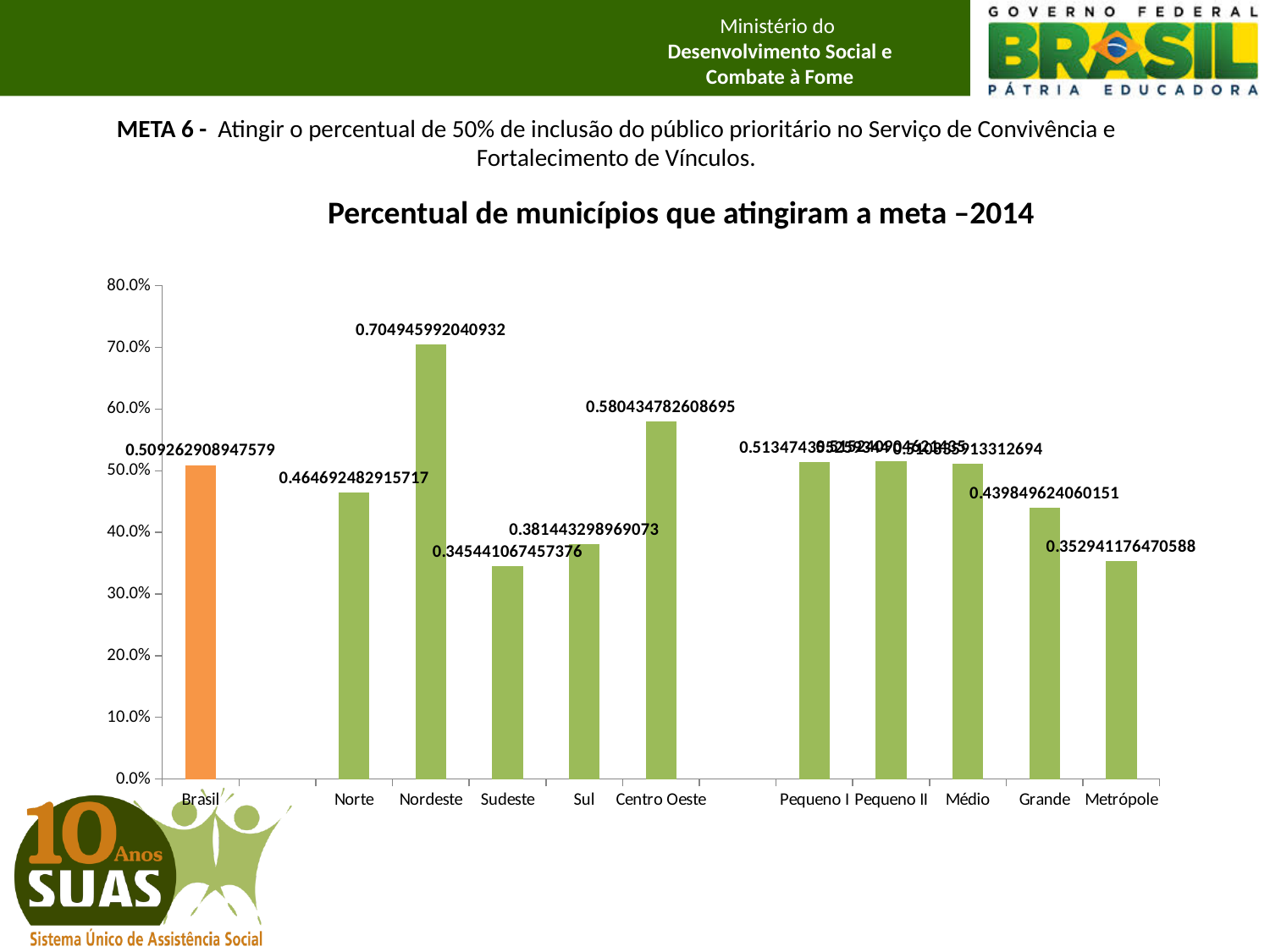
Which category has the highest value? Nordeste Is the value for Médio greater or less than 40.0%? greater How many categories are plotted on the x axis of the chart? 11 What is the title of the chart? Percentual de municípios que atingiram a meta –2014 What is the value shown for Metrópole? 0.352941176470588 What is the value shown for Centro Oeste? 0.580434782608695 What is the value shown for Nordeste? 0.704945992040932 What is the difference between the values for Nordeste and Sudeste? 0.359504924583556 Which bar is shown in a different colour (orange) from the others? Brasil Which has a larger value, Norte or Grande? Norte What is the value shown for Brasil? 0.509262908947579 What type of chart is shown on the slide? bar chart